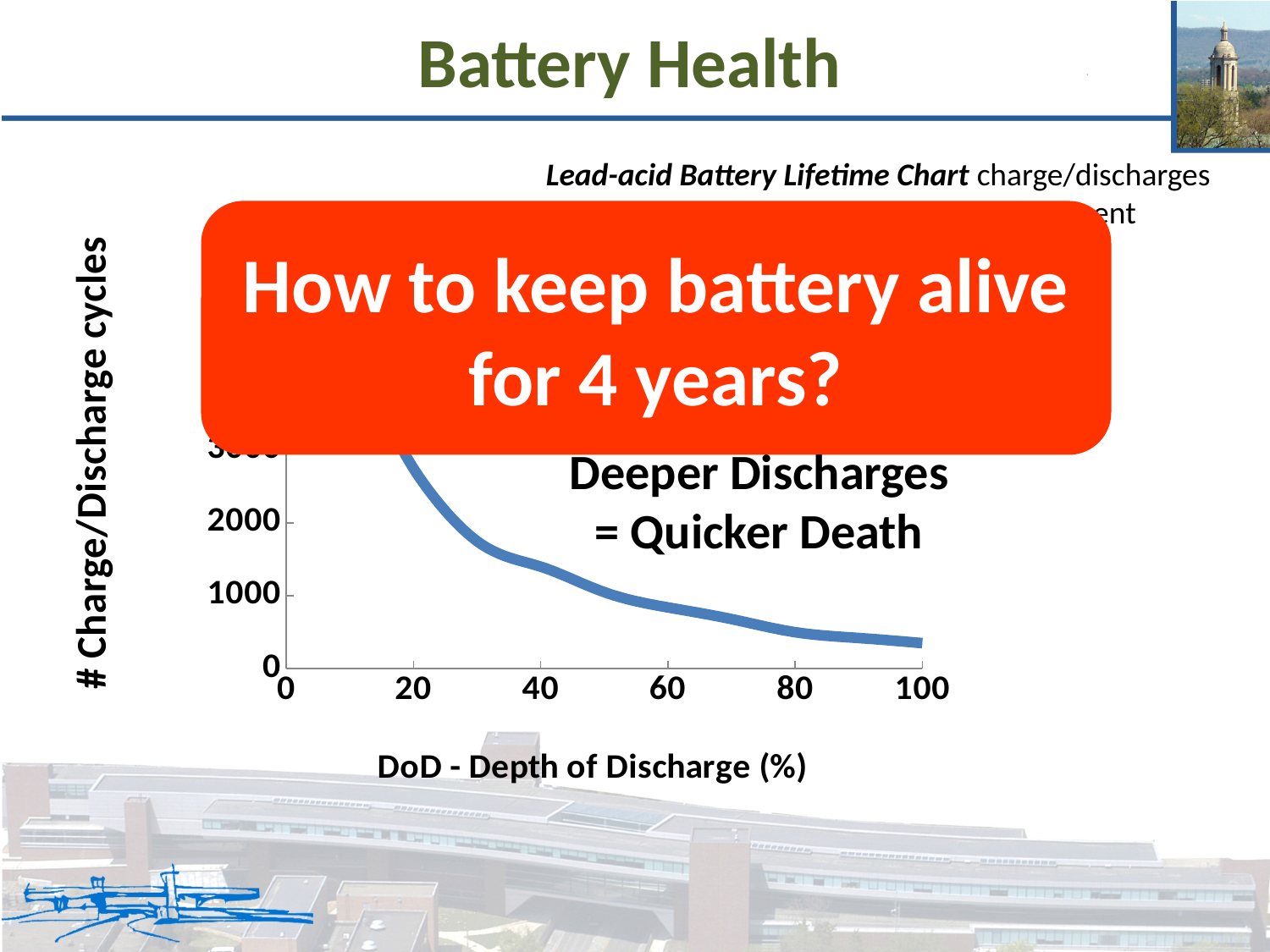
Is the number of charge/discharge cycles at 100% depth of discharge greater or less than 1000? less What kind of chart is the Lead-acid Battery Lifetime Chart? line chart Which has more charge/discharge cycles: 20% depth of discharge or 80% depth of discharge? 20% depth of discharge Do the charge/discharge cycles rise or fall as depth of discharge increases along the x axis? fall Is the number of charge/discharge cycles at 40% depth of discharge greater or less than 2000? less What is the label of the y axis of the chart? # Charge/Discharge cycles At which depth of discharge shown on the x axis is the number of charge/discharge cycles lowest? 100 What is the label of the x axis of the chart? DoD - Depth of Discharge (%) Is the number of charge/discharge cycles at 80% depth of discharge greater or less than 1000? less